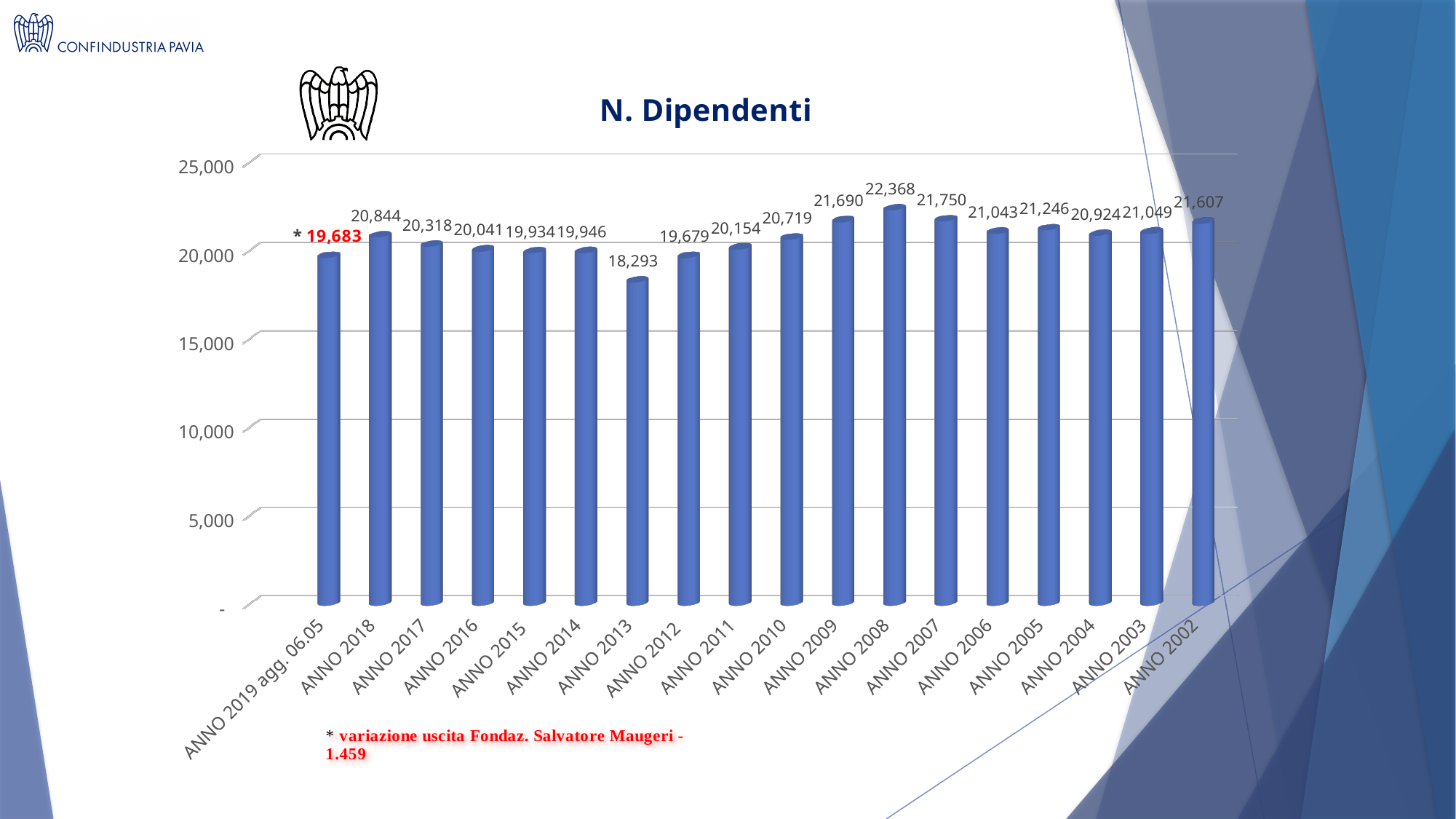
What is the difference between the values for ANNO 2008 and ANNO 2013? 4,075 What is the value for ANNO 2008? 22,368 How many bars are shown in the chart? 18 What is the title of the chart? N. Dipendenti Which year has the lowest number of employees? ANNO 2013 Which year has the highest number of employees? ANNO 2008 What is the difference between the values for ANNO 2018 and ANNO 2019 agg. 06.05? 1,161 Which is larger, the value for ANNO 2007 or the value for ANNO 2009? ANNO 2007 Is the value for ANNO 2013 greater or less than 20,000? less What is the value for ANNO 2019 agg. 06.05? 19,683 What is the value for ANNO 2013? 18,293 What kind of chart is shown on the slide? bar chart